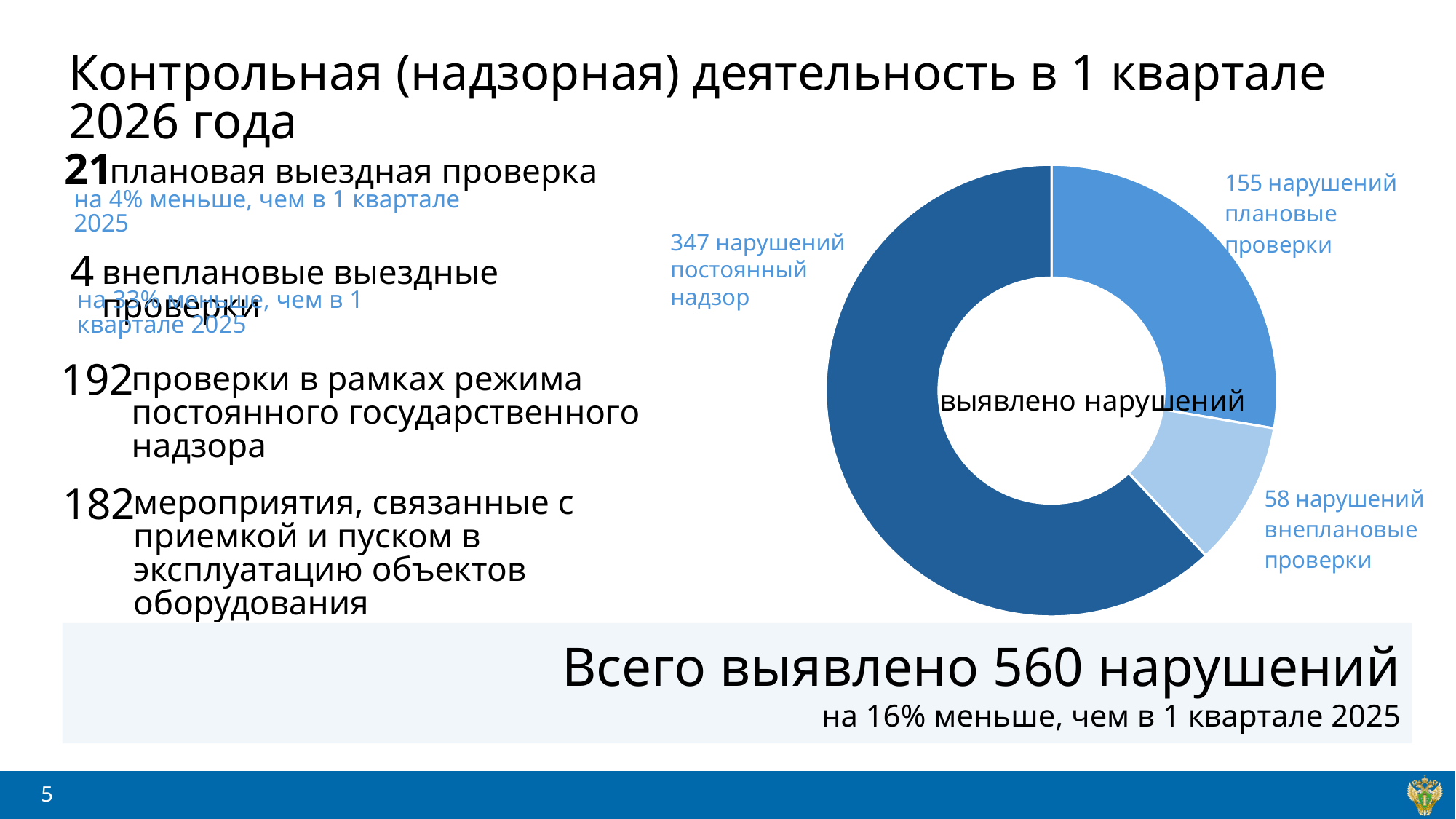
What text is written in the centre of the donut chart? выявлено нарушений How many violations were identified under permanent supervision (постоянный надзор) according to the chart? 347 How many violations were identified during unplanned inspections (внеплановые проверки) according to the chart? 58 How many violations were identified during planned inspections (плановые проверки) according to the chart? 155 What is the difference between violations from planned inspections and violations from unplanned inspections? 97 How many more violations were found under permanent supervision than during planned inspections? 192 What kind of chart is shown on the slide? Donut (pie) chart How many categories (slices) does the donut chart have? 3 Which category in the chart has the smallest number of violations? внеплановые проверки (58) What is the total number of violations across all slices of the chart? 560 Which category in the chart has the largest number of violations? постоянный надзор (347) Which is larger: violations from planned inspections or violations from unplanned inspections? плановые проверки (155)